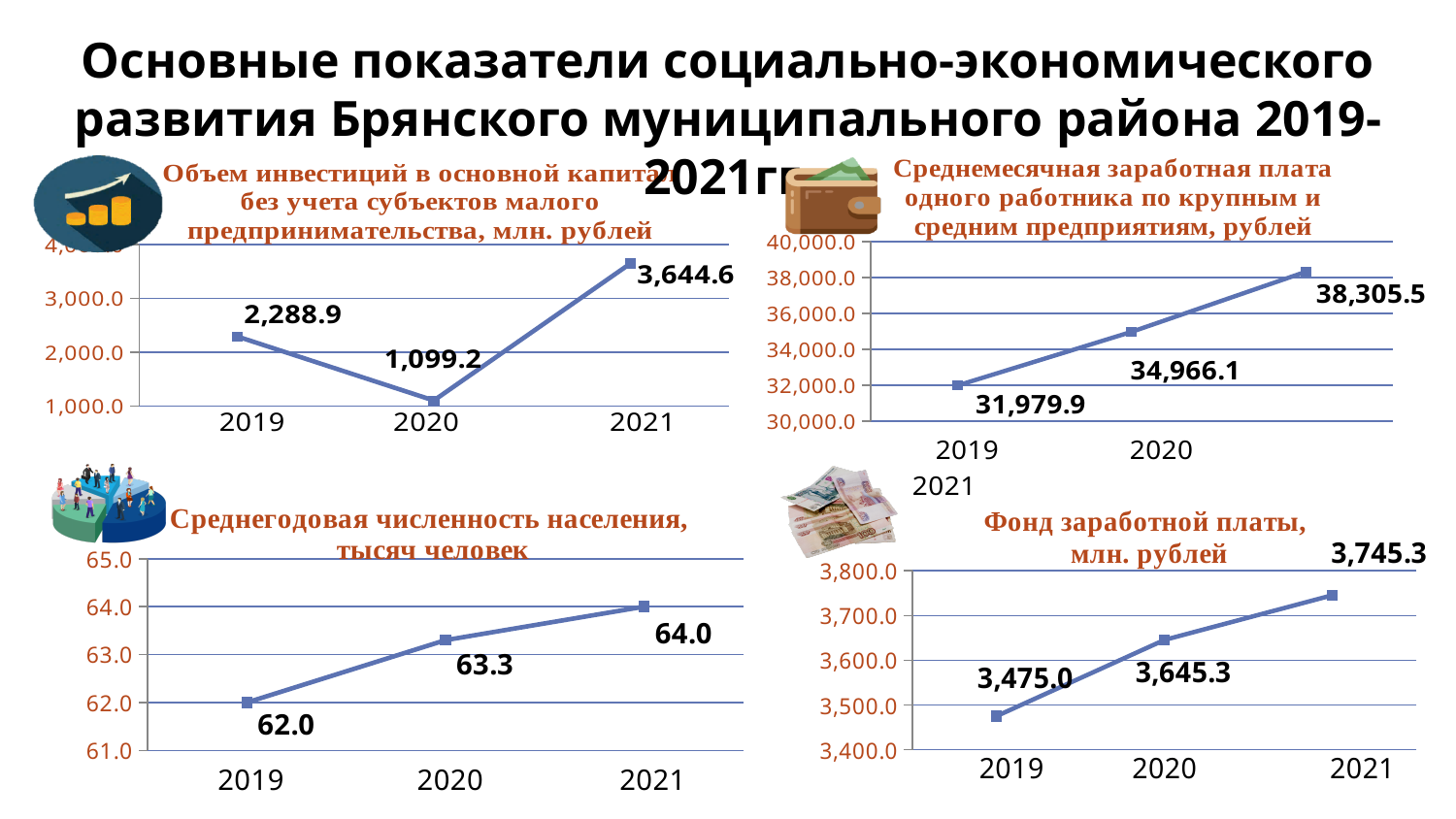
In the top-right chart (Среднемесячная заработная плата), what is the difference between the 2021 and 2020 values? 3,339.4 In the bottom-right chart (Фонд заработной платы), which is larger, the value for 2019 or the value for 2021? 2021 In the bottom-right chart (Фонд заработной платы), what is the value for 2020? 3,645.3 In the top-left chart (Объем инвестиций в основной капитал), what is the value for 2020? 1,099.2 In the bottom-left chart (Среднегодовая численность населения), what is the value for 2021? 64.0 In the top-left chart (Объем инвестиций в основной капитал), what is the difference between the 2021 and 2019 values? 1,355.7 In the top-right chart (Среднемесячная заработная плата), do the values rise or fall from 2019 to 2021? rise In the top-right chart (Среднемесячная заработная плата), what is the value for 2019? 31,979.9 In the top-left chart (Объем инвестиций в основной капитал), which year has the highest value? 2021 How many data points are plotted in the bottom-right chart (Фонд заработной платы)? 3 In the bottom-left chart (Среднегодовая численность населения), which year has the lowest value? 2019 What type of chart is the bottom-left chart (Среднегодовая численность населения)? line chart